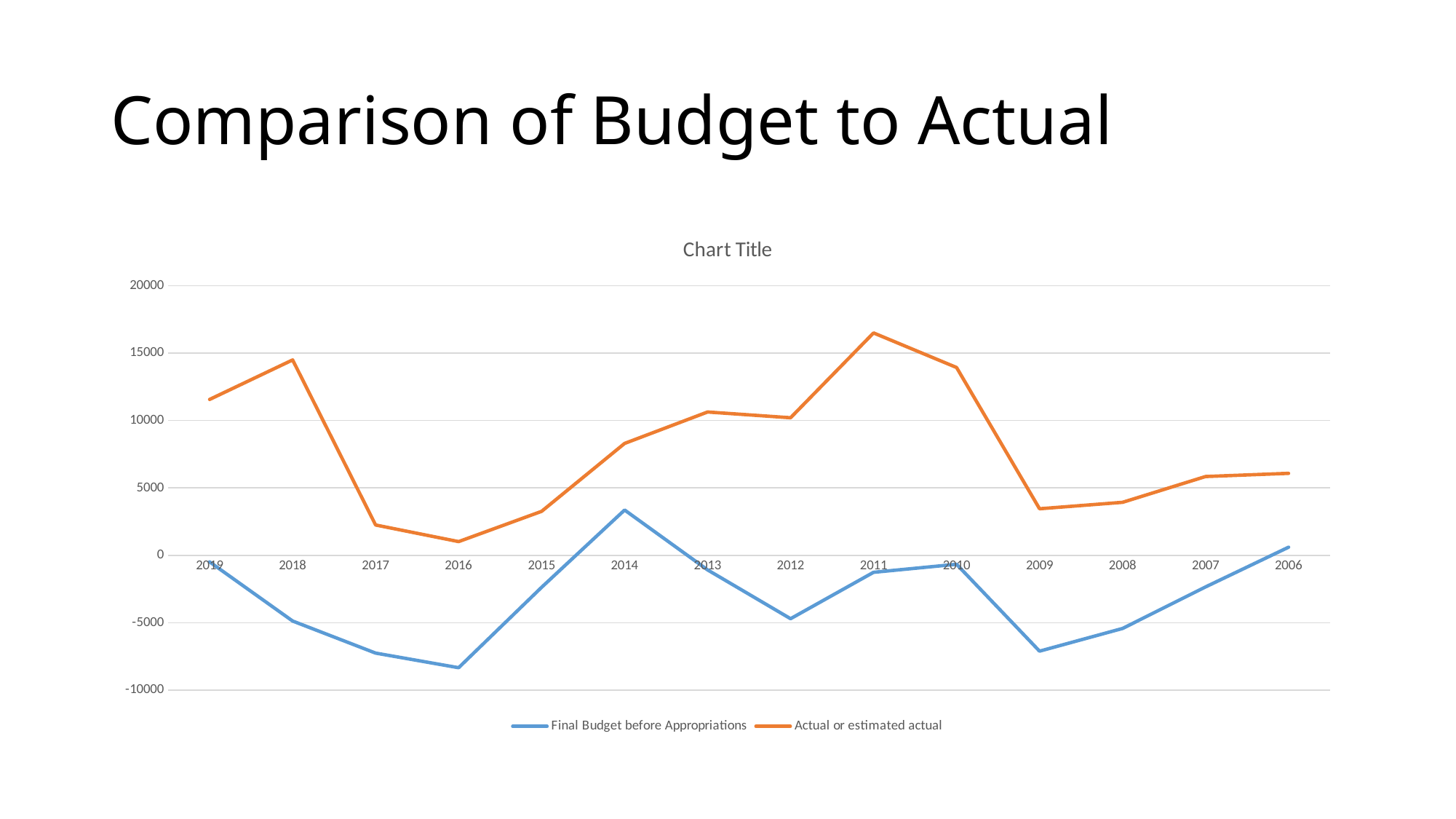
Is the Actual or estimated actual value for 2018 greater or less than 10000? greater What kind of chart is shown on the slide? line chart In which year is the Actual or estimated actual line at its highest? 2011 In which year is the Final Budget before Appropriations line at its highest? 2014 Is the Final Budget before Appropriations value for 2009 greater or less than -5000? less In which year is the Actual or estimated actual line at its lowest? 2016 Which year has the larger Actual or estimated actual value, 2019 or 2018? 2018 How many years are plotted along the x axis? 14 Between 2018 and 2016, does the Actual or estimated actual line rise or fall? fall How many series does the legend list? 2 Which series is drawn in orange? Actual or estimated actual In which year is the Final Budget before Appropriations line at its lowest? 2016